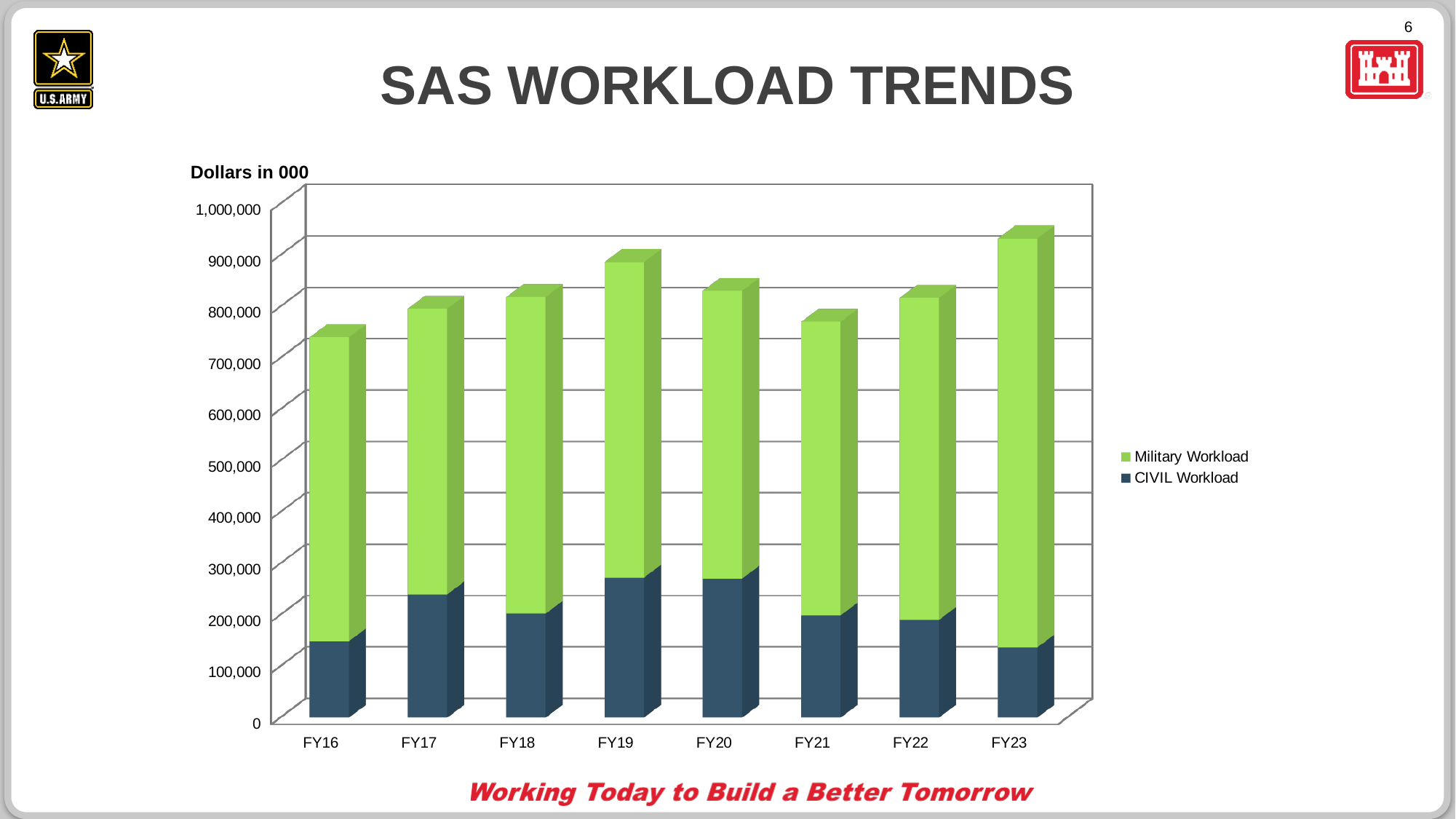
Is the CIVIL Workload value for FY19 greater or less than 200,000? greater Which has the larger total workload bar, FY19 or FY20? FY19 How many series does the chart legend list? 2 How many fiscal years are shown on the x axis of the chart? 8 Which series is shown in green in the chart? Military Workload Which fiscal year has the highest total workload bar? FY23 Is the total workload for FY23 greater or less than 900,000? greater What kind of chart is shown on the slide? Stacked bar chart Is the total workload for FY19 greater or less than 800,000? greater What unit label is shown above the vertical axis of the chart? Dollars in 000